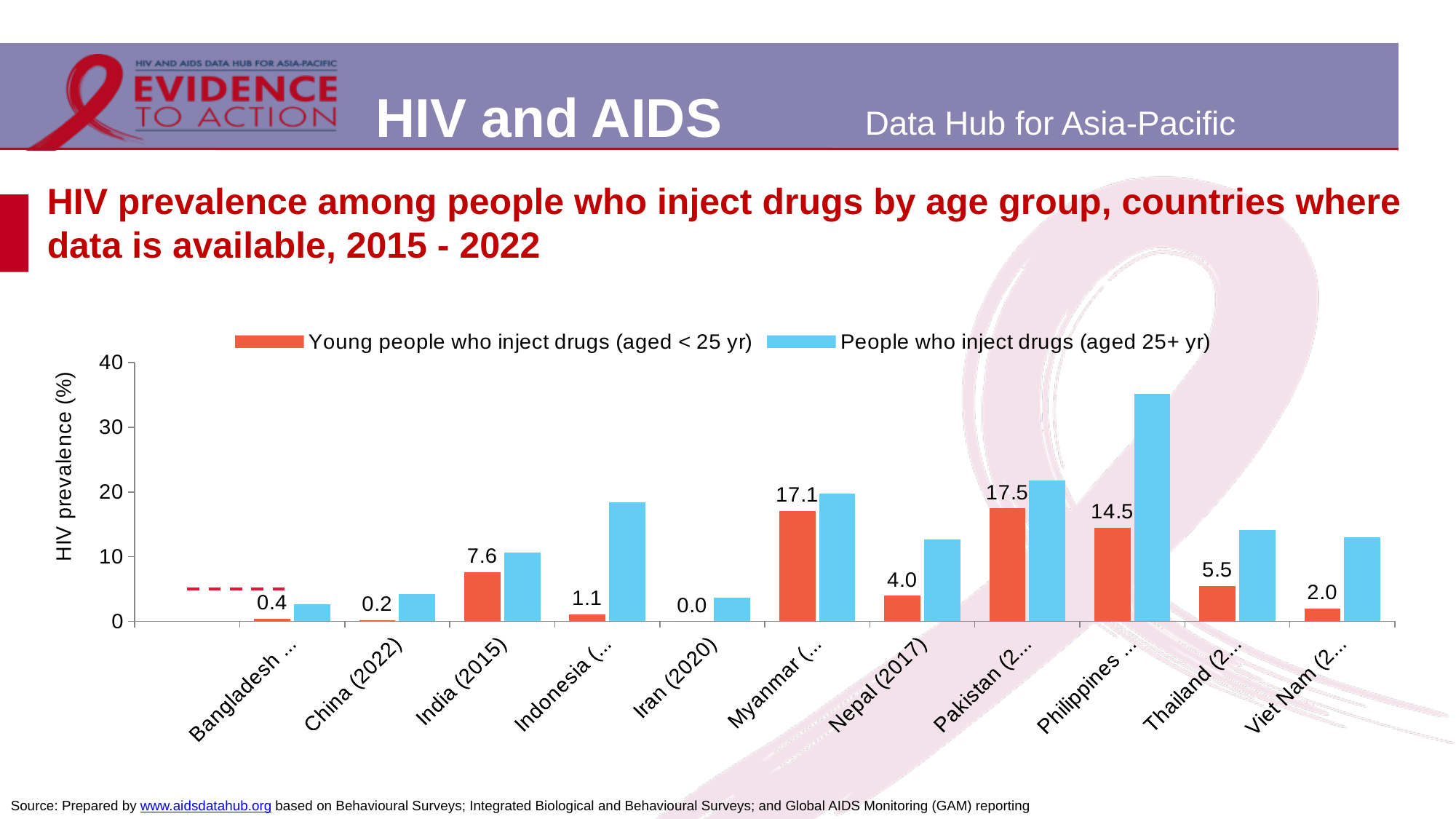
Which is larger for young people who inject drugs (aged < 25 yr): Thailand or Viet Nam? Thailand How many countries are shown on the x axis of the chart? 11 Is the value for people who inject drugs (aged 25+ yr) in Indonesia greater or less than 10? greater Which country has the highest HIV prevalence among young people who inject drugs (aged < 25 yr)? Pakistan Which country has the lowest HIV prevalence among young people who inject drugs (aged < 25 yr)? Iran How many series does the legend list? 2 Which country has the highest HIV prevalence among people who inject drugs (aged 25+ yr)? Philippines What is the difference between the young people who inject drugs (aged < 25 yr) values for Pakistan and the Philippines? 3.0 What is the HIV prevalence among young people who inject drugs (aged < 25 yr) in Nepal (2017)? 4.0 What kind of chart is shown on the slide? Bar chart Is the value for people who inject drugs (aged 25+ yr) in the Philippines greater or less than 30? greater What is the HIV prevalence among young people who inject drugs (aged < 25 yr) in India (2015)? 7.6